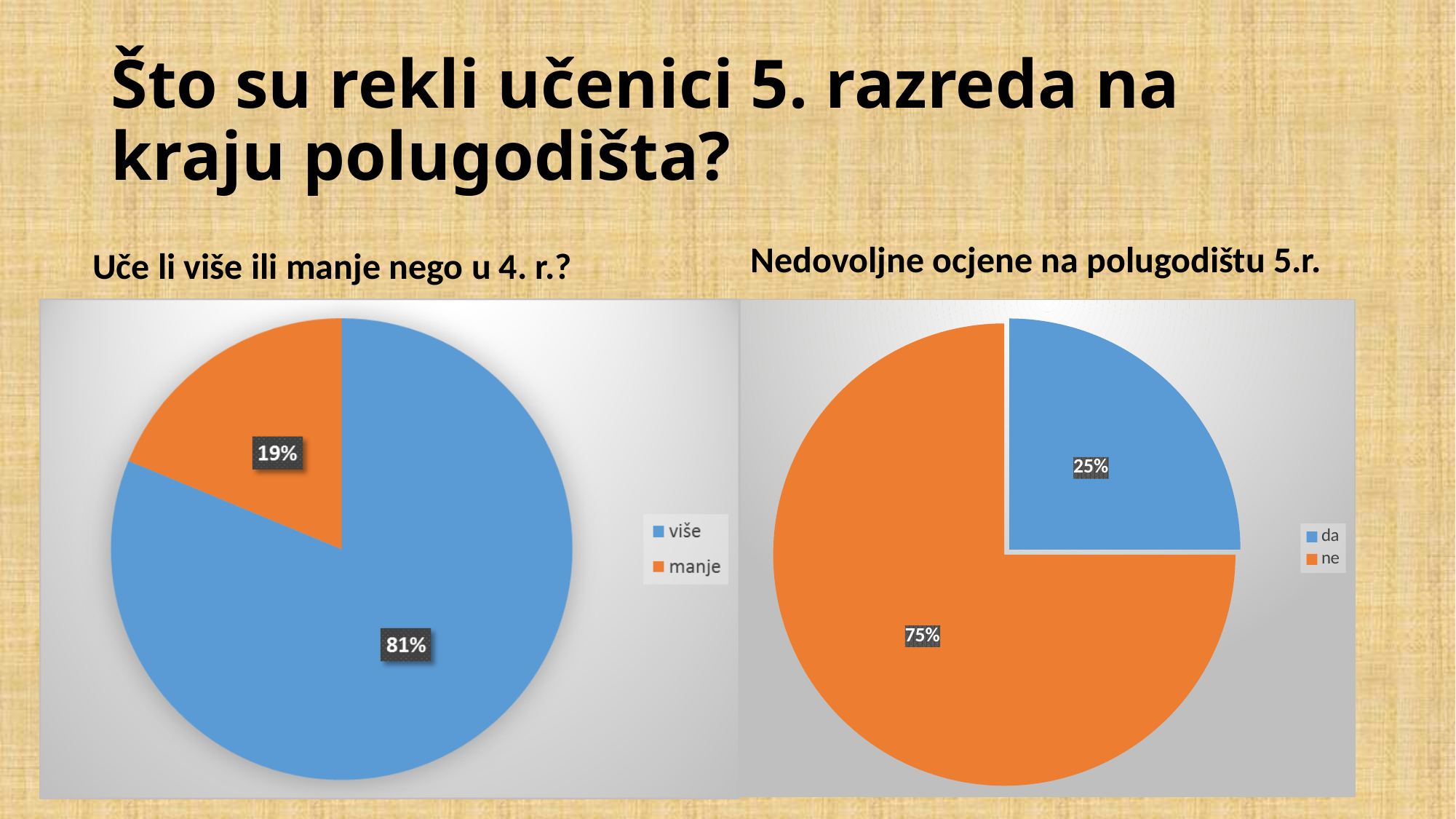
In the left chart 'Uče li više ili manje nego u 4. r.?', which category has the largest slice? više How many categories does the legend of the right chart 'Nedovoljne ocjene na polugodištu 5.r.' list? 2 In the right chart 'Nedovoljne ocjene na polugodištu 5.r.', what share is labelled for 'da'? 25% In the left chart 'Uče li više ili manje nego u 4. r.?', what share is labelled for 'više'? 81% In the left chart 'Uče li više ili manje nego u 4. r.?', what colour is the 'manje' slice? orange In the left chart 'Uče li više ili manje nego u 4. r.?', what share is labelled for 'manje'? 19% What type of chart is the left chart 'Uče li više ili manje nego u 4. r.?'? pie chart In the right chart 'Nedovoljne ocjene na polugodištu 5.r.', what is the difference in percentage points between 'ne' and 'da'? 50 In the right chart 'Nedovoljne ocjene na polugodištu 5.r.', which is larger, 'da' or 'ne'? ne In the left chart 'Uče li više ili manje nego u 4. r.?', what is the difference in percentage points between 'više' and 'manje'? 62 In the right chart 'Nedovoljne ocjene na polugodištu 5.r.', which category has the smallest slice? da In the right chart 'Nedovoljne ocjene na polugodištu 5.r.', what share is labelled for 'ne'? 75%